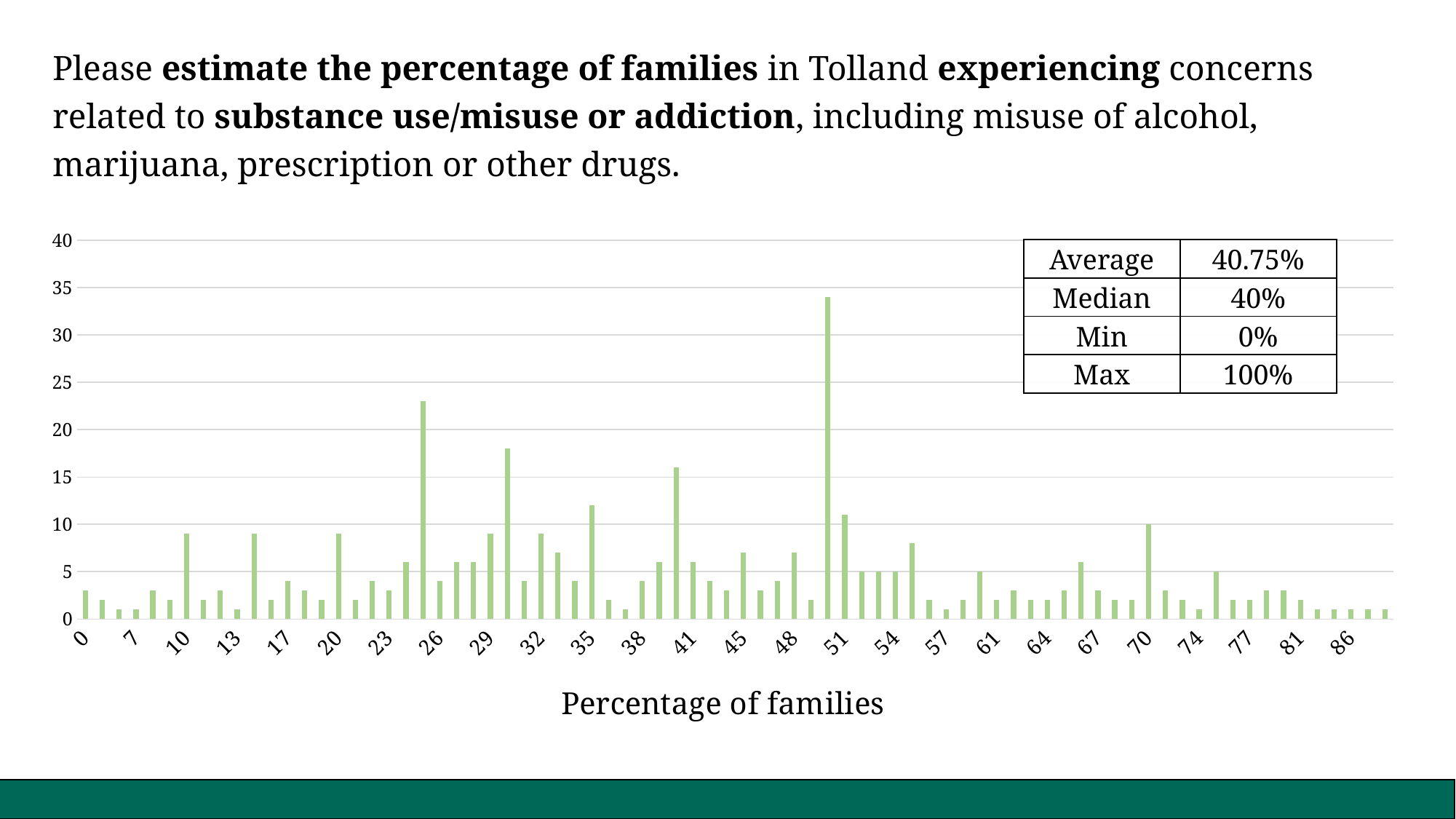
Is the value of the bar at the 0 tick greater or less than 5? less Is the value of the tallest bar in the chart greater or less than 30? greater Is the value of the tallest bar in the chart greater or less than 35? less Which is taller: the tallest bar near the 51 tick or the tallest bar near the 26 tick? the bar near the 51 tick According to the table on the slide, what is the average estimate? 40.75% According to the table on the slide, what is the minimum estimate? 0% What is the highest value shown on the y-axis? 40 What is the x-axis title of the chart? Percentage of families According to the table on the slide, what is the maximum estimate? 100% According to the table on the slide, what is the median estimate? 40% What kind of chart is shown on the slide? bar chart